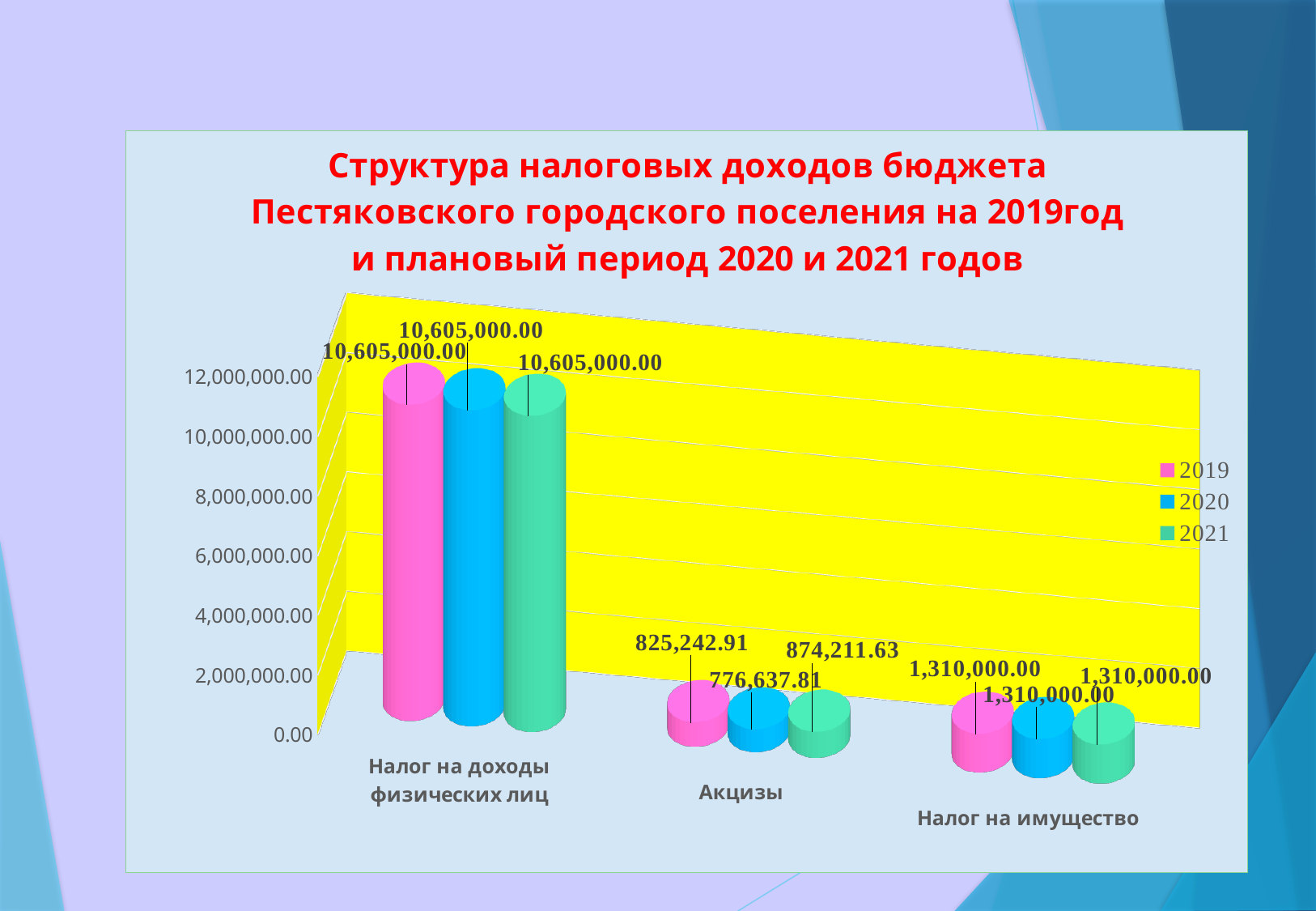
What is the value for Акцизы in 2021? 874,211.63 Which category has the highest value in 2020? Налог на доходы физических лиц Which is larger for Акцизы: the 2019 value or the 2020 value? 2019 How many categories are shown on the x axis? 3 What is the value for Налог на доходы физических лиц in 2019? 10,605,000.00 What kind of chart is shown on the slide? Bar chart What is the value for Акцизы in 2020? 776,637.81 Which category has the lowest value in 2019? Акцизы Which year has the highest value for Акцизы? 2021 What is the difference between the 2021 and 2020 values for Акцизы? 97,573.82 How many series does the legend list? 3 What is the value for Налог на имущество in 2021? 1,310,000.00